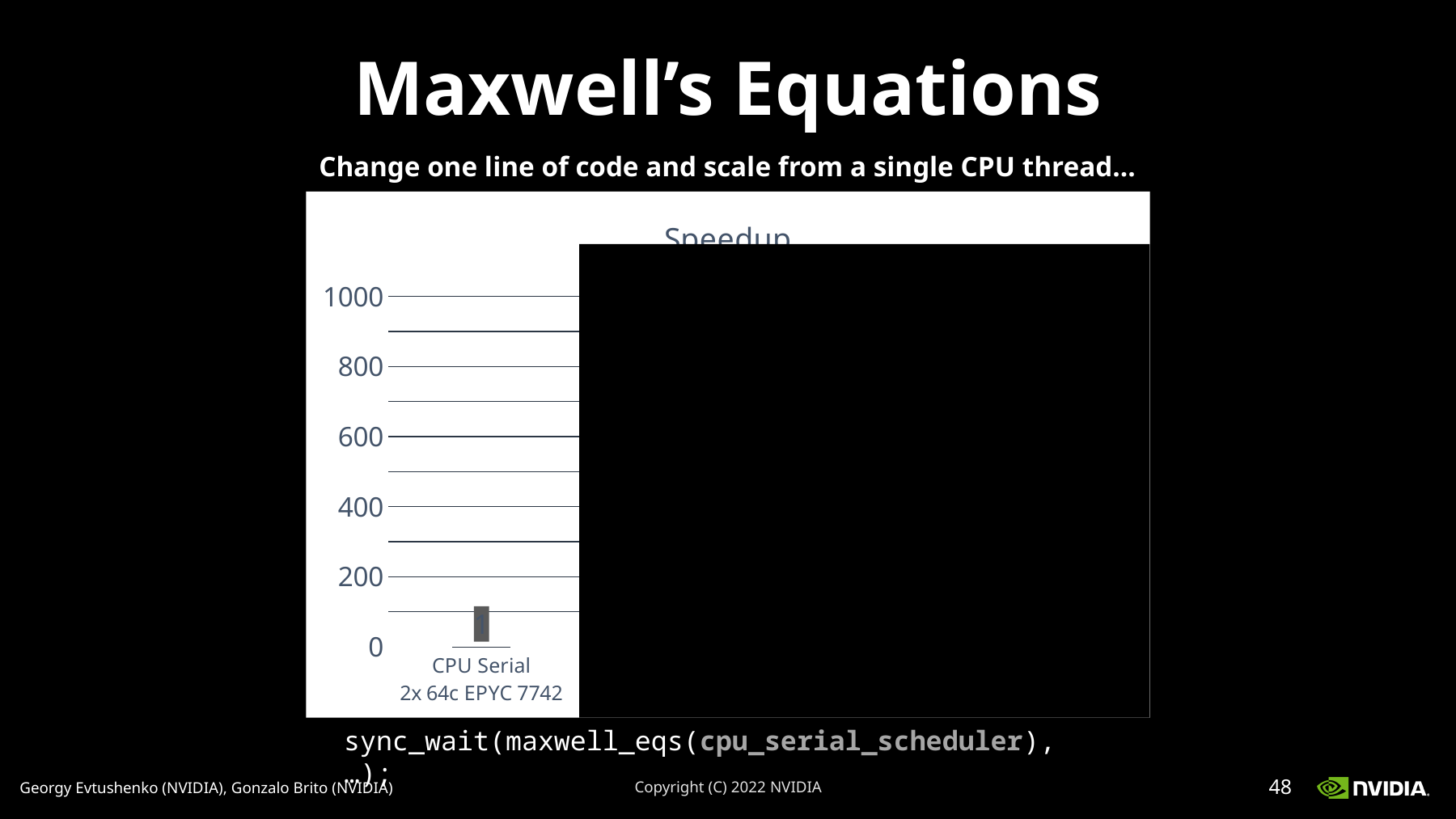
Is the value for CPU Serial greater or less than 200? less What is the title of the chart? Speedup Is the value for CPU Serial greater or less than 1000? less How many bars are visible in the chart? 1 What is the highest value labelled on the vertical axis of the chart? 1000 What is the speedup value shown for CPU Serial? 1 What kind of chart is shown on the slide? bar chart